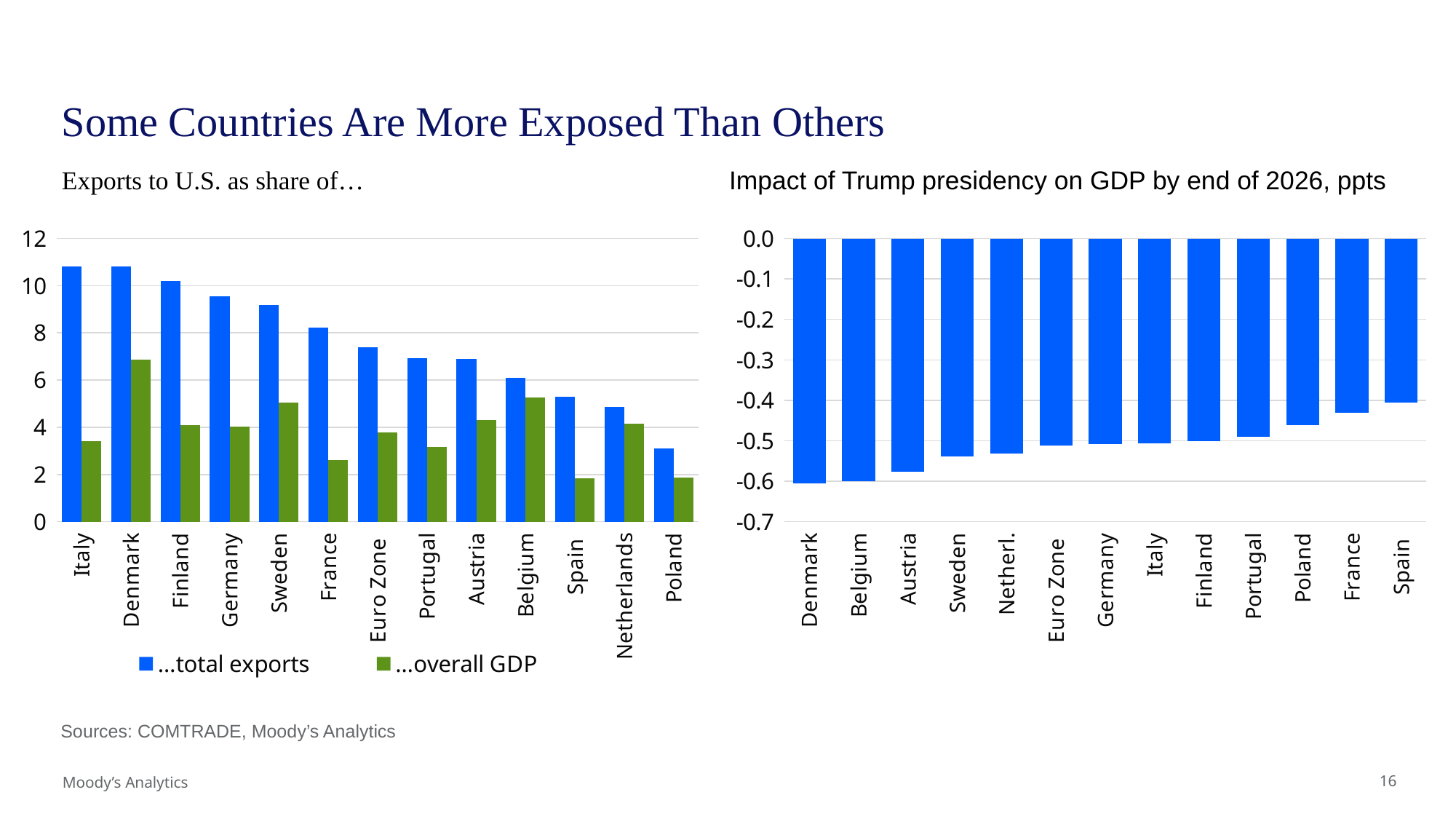
In the right chart 'Impact of Trump presidency on GDP by end of 2026, ppts', do the values rise or fall moving from Denmark on the left to Spain on the right? rise In the left chart 'Exports to U.S. as share of…', which is larger for Belgium: '…total exports' or '…overall GDP'? …total exports In the left chart 'Exports to U.S. as share of…', is the '…overall GDP' value for France greater or less than 4? less In the right chart 'Impact of Trump presidency on GDP by end of 2026, ppts', is the value for Spain greater or less than -0.5? greater What is the title of the right chart? Impact of Trump presidency on GDP by end of 2026, ppts What kind of chart is the left chart titled 'Exports to U.S. as share of…'? bar chart How many countries/regions are shown on the x axis of the left chart 'Exports to U.S. as share of…'? 13 How many series does the legend of the left chart 'Exports to U.S. as share of…' list? 2 In the left chart 'Exports to U.S. as share of…', which category has the lowest value for '…total exports'? Poland In the right chart 'Impact of Trump presidency on GDP by end of 2026, ppts', which country has the lowest (most negative) value? Denmark In the left chart 'Exports to U.S. as share of…', is the '…total exports' value for Italy greater or less than 10? greater In the left chart 'Exports to U.S. as share of…', which category has the highest value for '…overall GDP'? Denmark